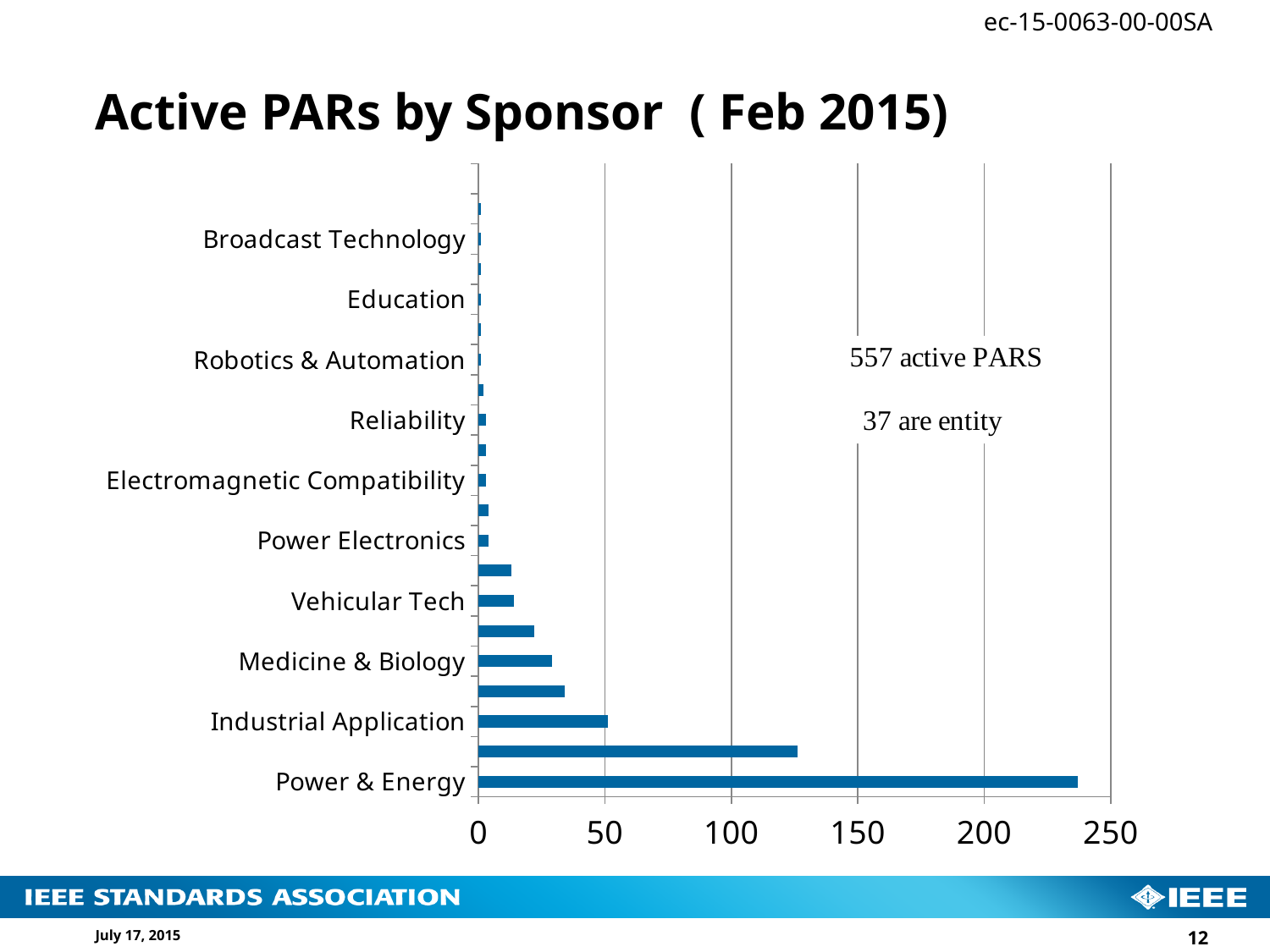
Which is larger, the value for Medicine & Biology or the value for Vehicular Tech? Medicine & Biology What is the title of the chart? Active PARs by Sponsor ( Feb 2015) Which is larger, the value for Power & Energy or the value for Industrial Application? Power & Energy Is the value for Medicine & Biology greater or less than 50? less Is the value for Reliability greater or less than 50? less Which is larger, the value for Vehicular Tech or the value for Power Electronics? Vehicular Tech What kind of chart is shown on the slide? bar chart Which sponsor has the highest number of active PARs? Power & Energy Is the value for Power & Energy greater or less than 200? greater According to the text annotation on the chart, how many active PARs are there in total? 557 How many sponsor labels are shown on the vertical axis of the chart? 10